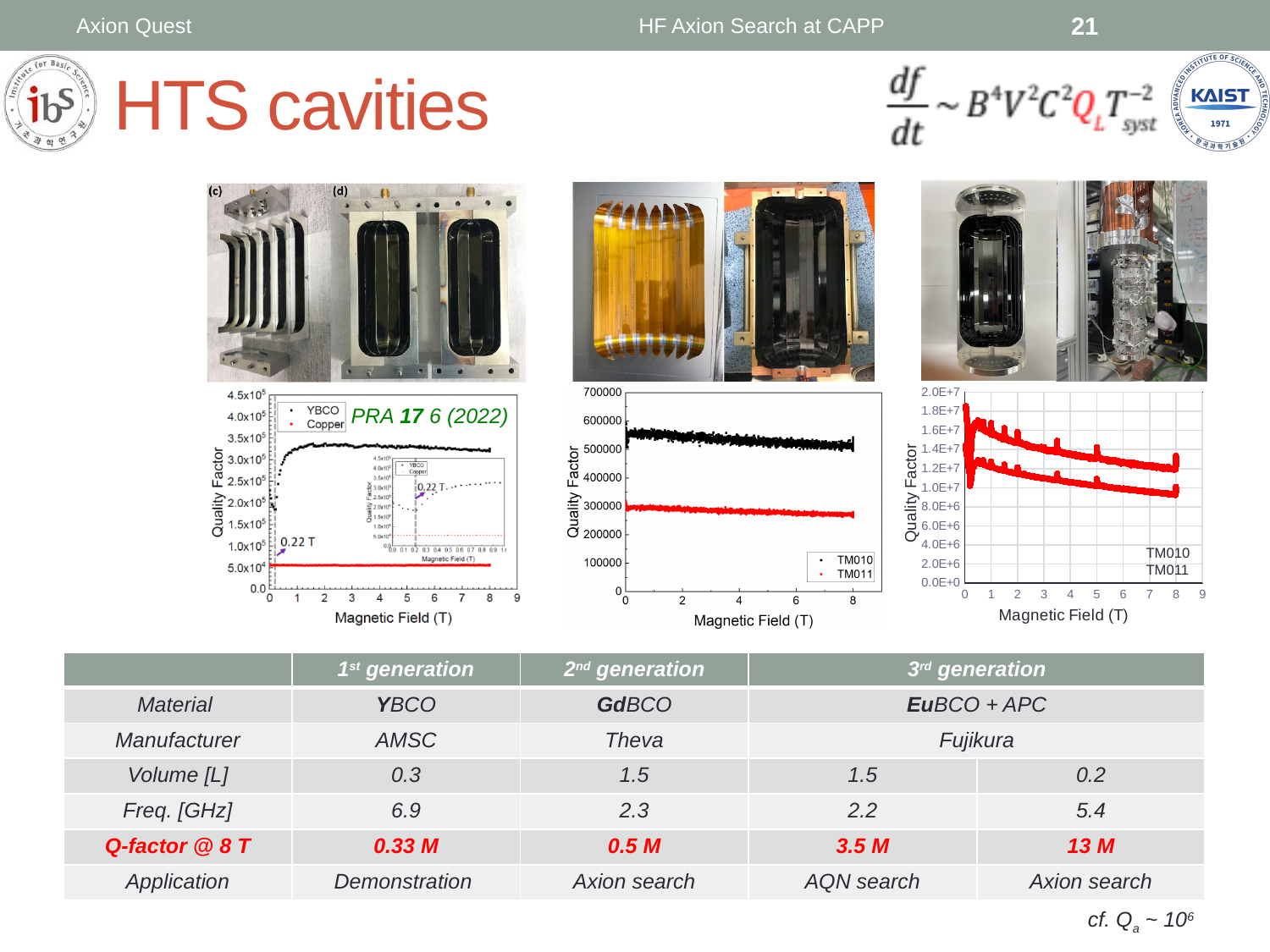
On the middle chart (TM010 vs TM011, y axis up to 700000), is the quality factor of TM011 greater or less than 400000? less What is the x-axis label shared by the three charts on the slide? Magnetic Field (T) On the middle chart (TM010 vs TM011, y axis up to 700000), which series has the higher quality factor, TM010 or TM011? TM010 On the right chart (y axis up to 2.0E+7), is the quality factor of the lower curve at 8 T greater or less than 1.4E+7? less On the middle chart (TM010 vs TM011, y axis up to 700000), is the quality factor of TM010 greater or less than 400000? greater On the left chart (YBCO vs Copper), what magnetic field value is annotated with an arrow near the start of the curves? 0.22 T On the middle chart (TM010 vs TM011, y axis up to 700000), does the quality factor of TM010 rise or fall as the magnetic field increases? fall On the right chart (y axis up to 2.0E+7), how many series does the legend list? 2 On the left chart (YBCO vs Copper), which series has the higher quality factor at 8 T, YBCO or Copper? YBCO On the left chart (YBCO vs Copper), how many series does the legend list? 2